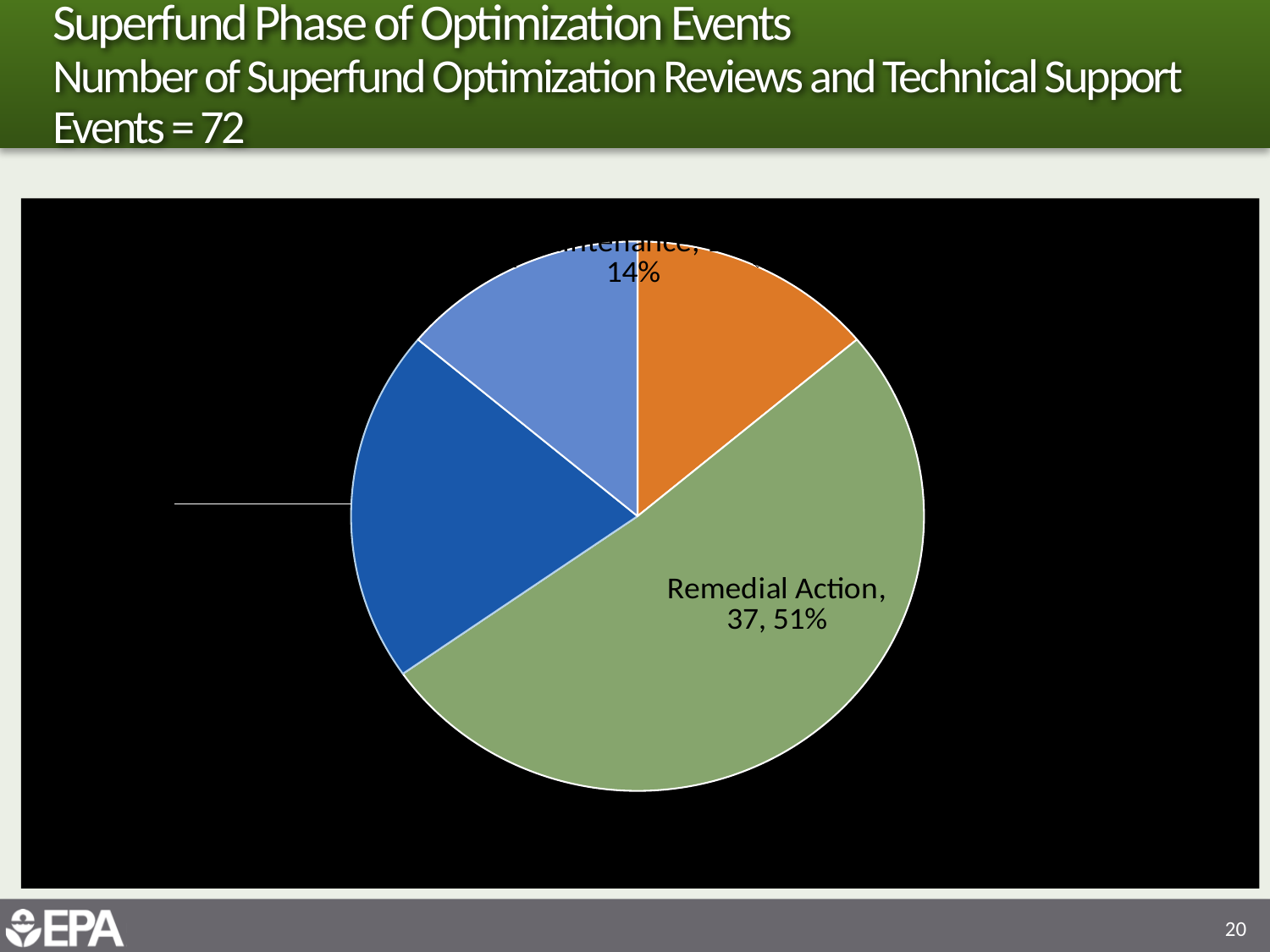
How many slices does the pie chart have? 4 Does the Remedial Action slice account for more or less than half of the pie? more According to the slide title, what is the total number of Superfund Optimization Reviews and Technical Support Events? 72 Which slice of the pie chart is the largest? Remedial Action How many events are in the Remedial Action slice? 37 What share of the pie does the Remedial Action slice represent? 51% What kind of chart is shown on the slide? pie chart What colour is the Remedial Action slice? green